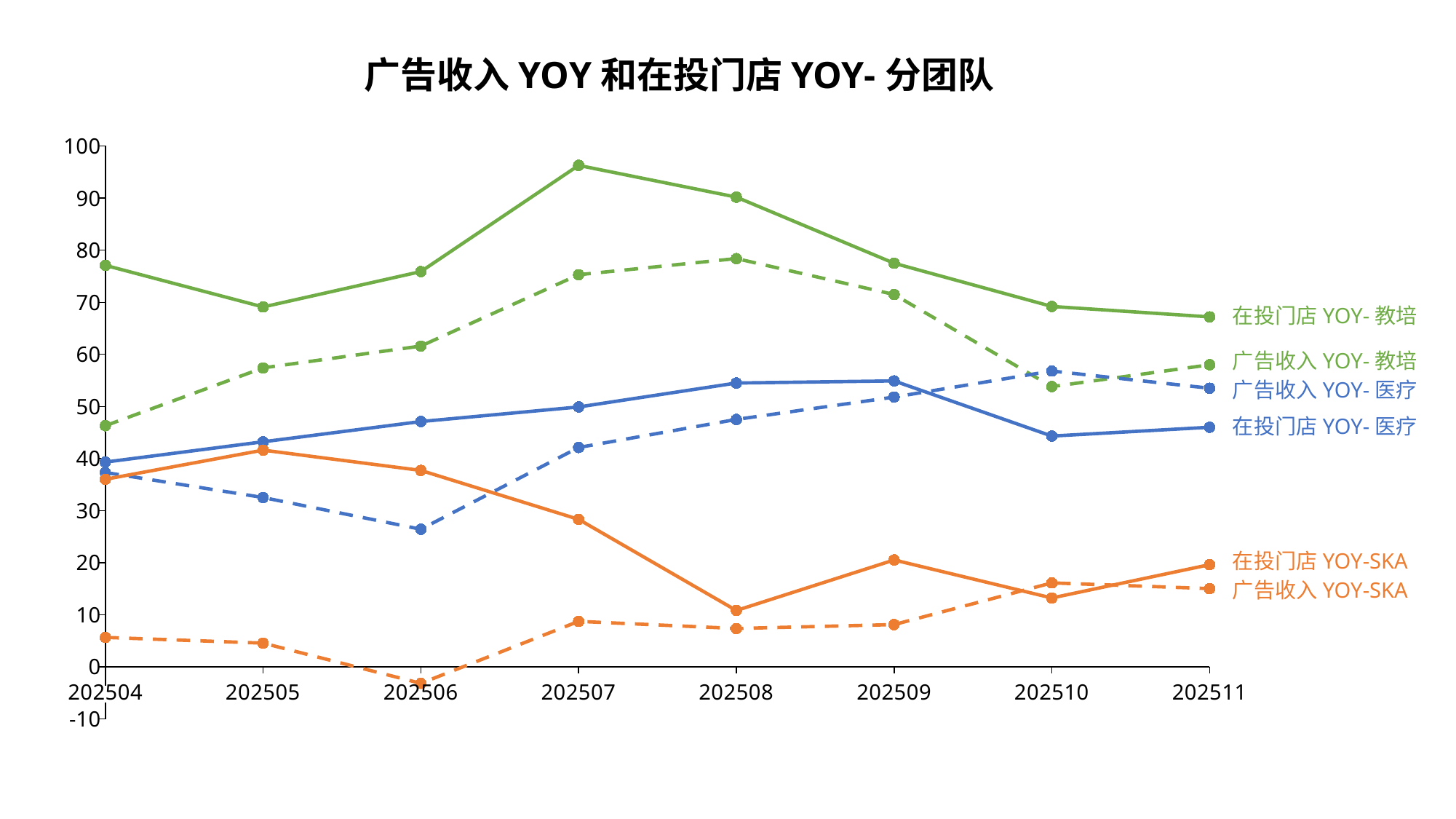
Which series has the highest value at 202507? 在投门店 YOY- 教培 What type of chart is shown on the slide? line chart At which x-axis point does 在投门店 YOY- 教培 reach its peak? 202507 Is the value for 广告收入 YOY-SKA at 202506 greater or less than 0? less Is the value for 在投门店 YOY- 教培 at 202507 greater or less than 90? greater What is the title of the chart? 广告收入 YOY 和在投门店 YOY- 分团队 Which series has the lowest value at 202506? 广告收入 YOY-SKA Is the value for 在投门店 YOY- 医疗 at 202508 greater or less than 50? greater How many series are labelled on the chart? 6 At 202510, which is larger: 广告收入 YOY- 医疗 or 在投门店 YOY- 医疗? 广告收入 YOY- 医疗 How many time points are shown on the x axis? 8 Does 在投门店 YOY-SKA rise or fall from 202505 to 202508? fall